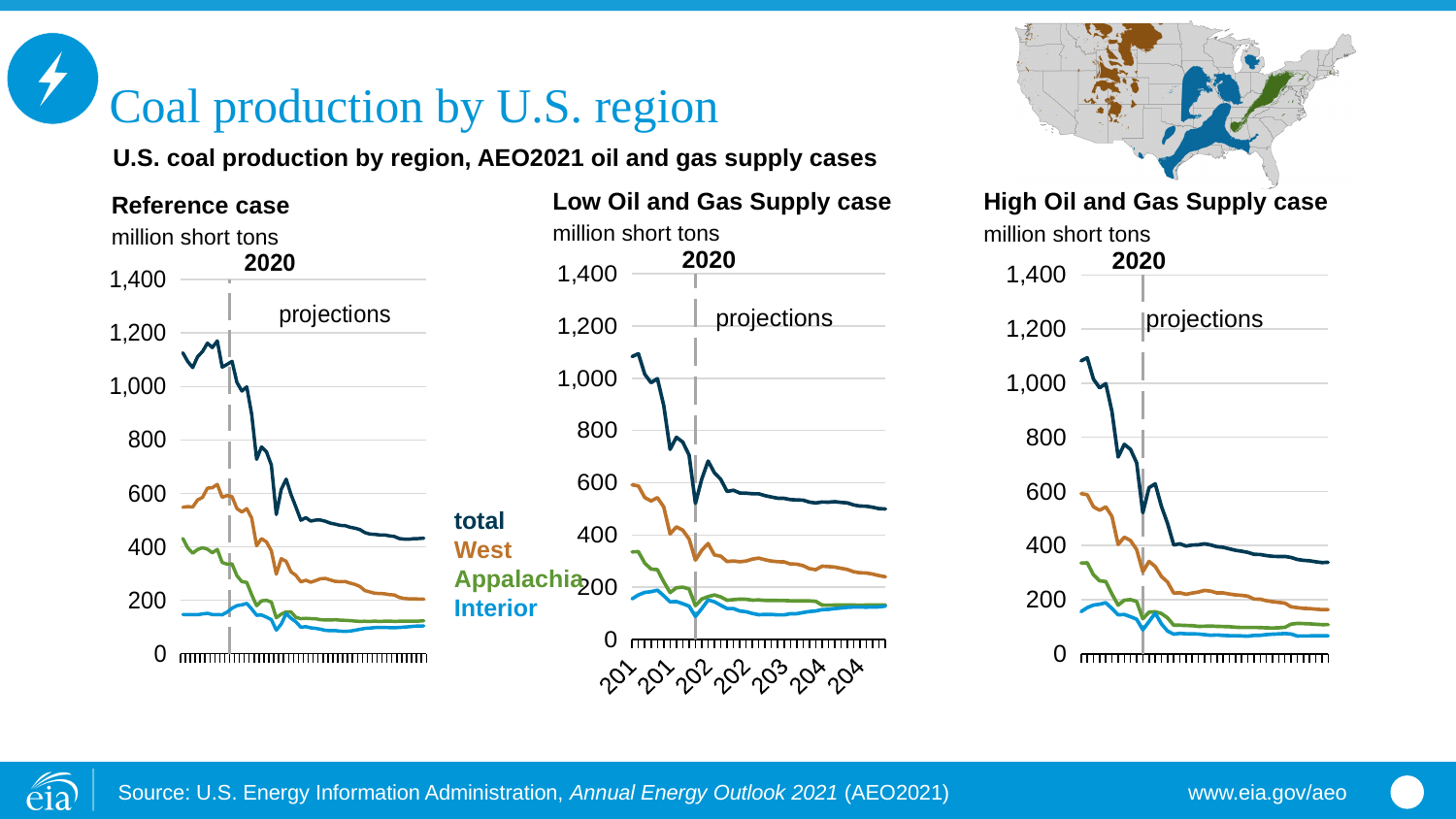
How many series does the legend list for the coal production charts? 4 What unit is used on the y axis of the three charts? million short tons What kind of chart is the Reference case chart? line chart In the Reference case chart, is the value of the total series at the start of the period greater or less than 1,000? greater In the Low Oil and Gas Supply case chart, is the value of the Appalachia series at the end of the projection period greater or less than 200? less In the Reference case chart, does the total series rise or fall over the period shown? fall In the High Oil and Gas Supply case chart, is the value of the total series at the end of the projection period greater or less than 400? less In the High Oil and Gas Supply case chart, which series is lowest at the end of the projection period? Interior In the Reference case chart, which series has the highest values throughout the period? total In the Reference case chart, at the end of the projection period, which is larger: West or Appalachia? West